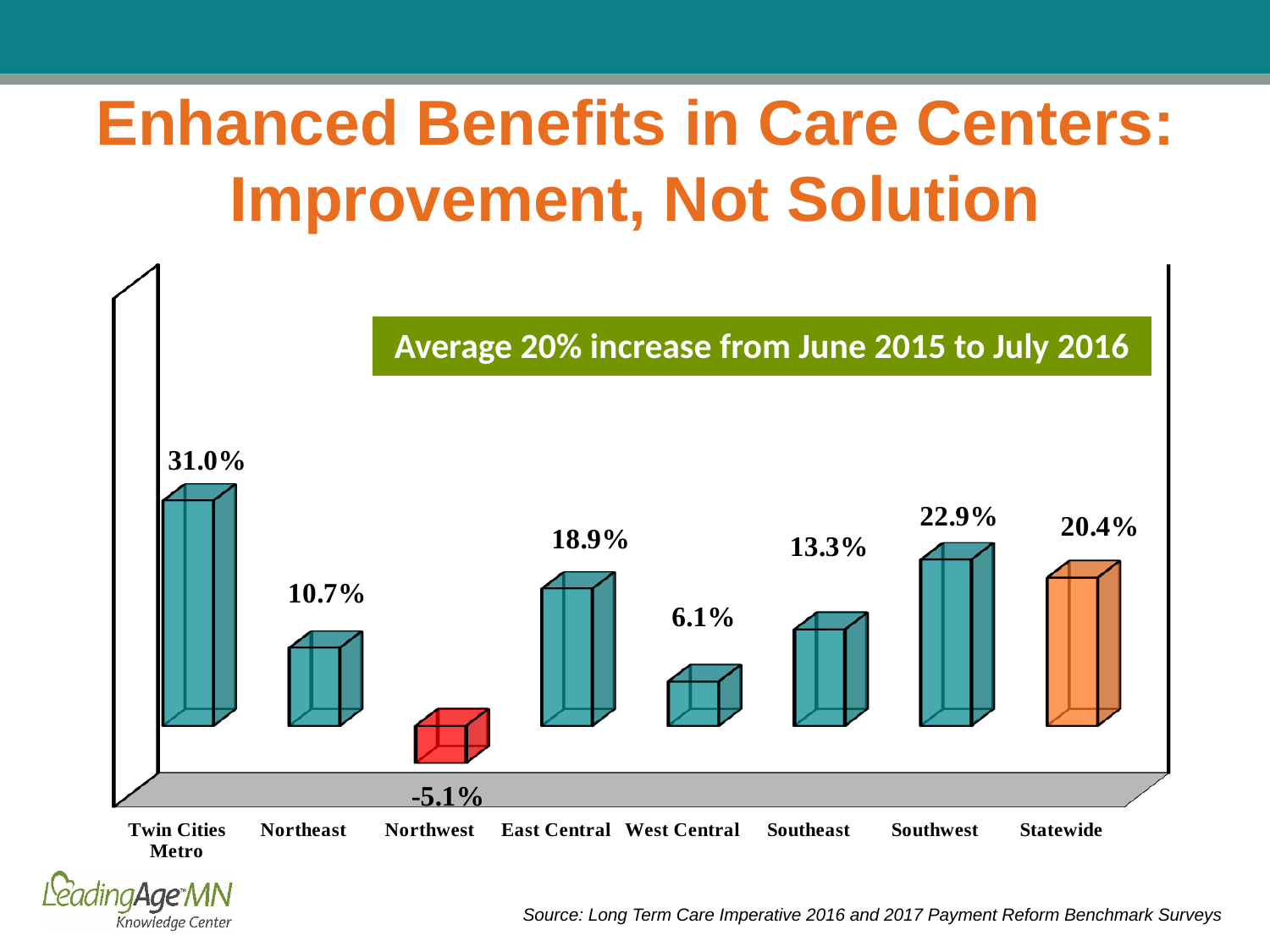
Which is larger, the value for Southeast or the value for Northeast? Southeast What is the difference between the values for Twin Cities Metro and Statewide? 10.6% Which category has the highest value? Twin Cities Metro What is the value for Northwest? -5.1% How many categories are shown on the chart? 8 What is the difference between the values for East Central and West Central? 12.8% What is the value for Twin Cities Metro? 31.0% Which category has the lowest value? Northwest What does the green text box on the chart say? Average 20% increase from June 2015 to July 2016 What is the value for Southwest? 22.9% What is the value for Statewide? 20.4% What kind of chart is shown on the slide? Bar chart